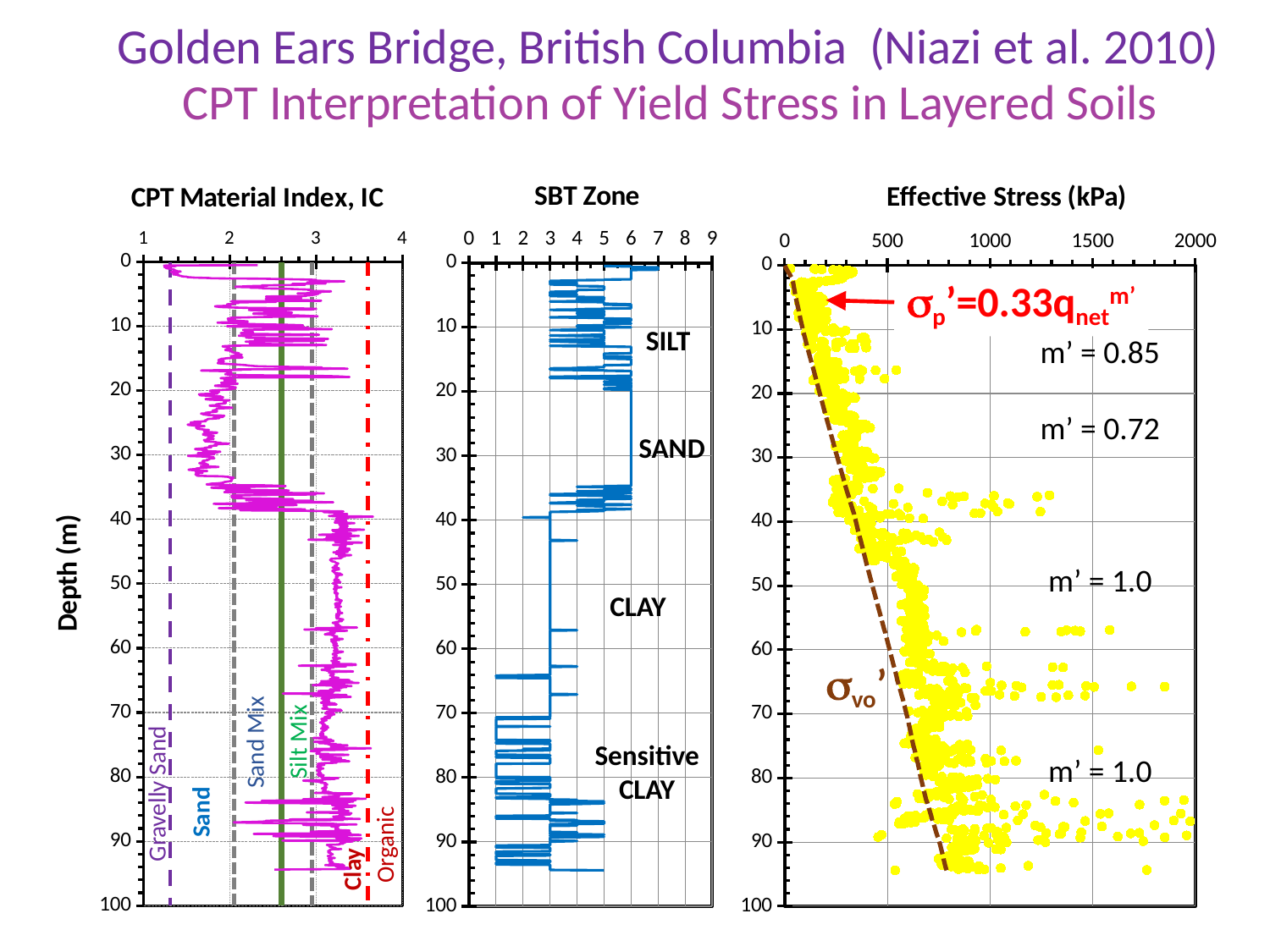
What kind of chart is the Effective Stress (kPa) chart on the right? scatter chart In the SBT Zone chart, is the SBT zone value at a depth of 25 m greater or less than 5? greater What is the title of the left-hand chart? CPT Material Index, IC In the CPT Material Index, IC chart, is the IC value at a depth of 25 m greater or less than 2? less In the Effective Stress (kPa) chart, does the σvo' line rise or fall as depth increases? rise In the CPT Material Index, IC chart, is the IC value at a depth of 50 m greater or less than 3? greater In the SBT Zone chart, which soil type is labelled between about 40 m and 60 m depth? CLAY What kind of chart is the SBT Zone chart in the middle? line chart In the Effective Stress (kPa) chart, what is the maximum value shown on the horizontal axis? 2000 In the CPT Material Index, IC chart, what is the maximum value shown on the horizontal axis? 4